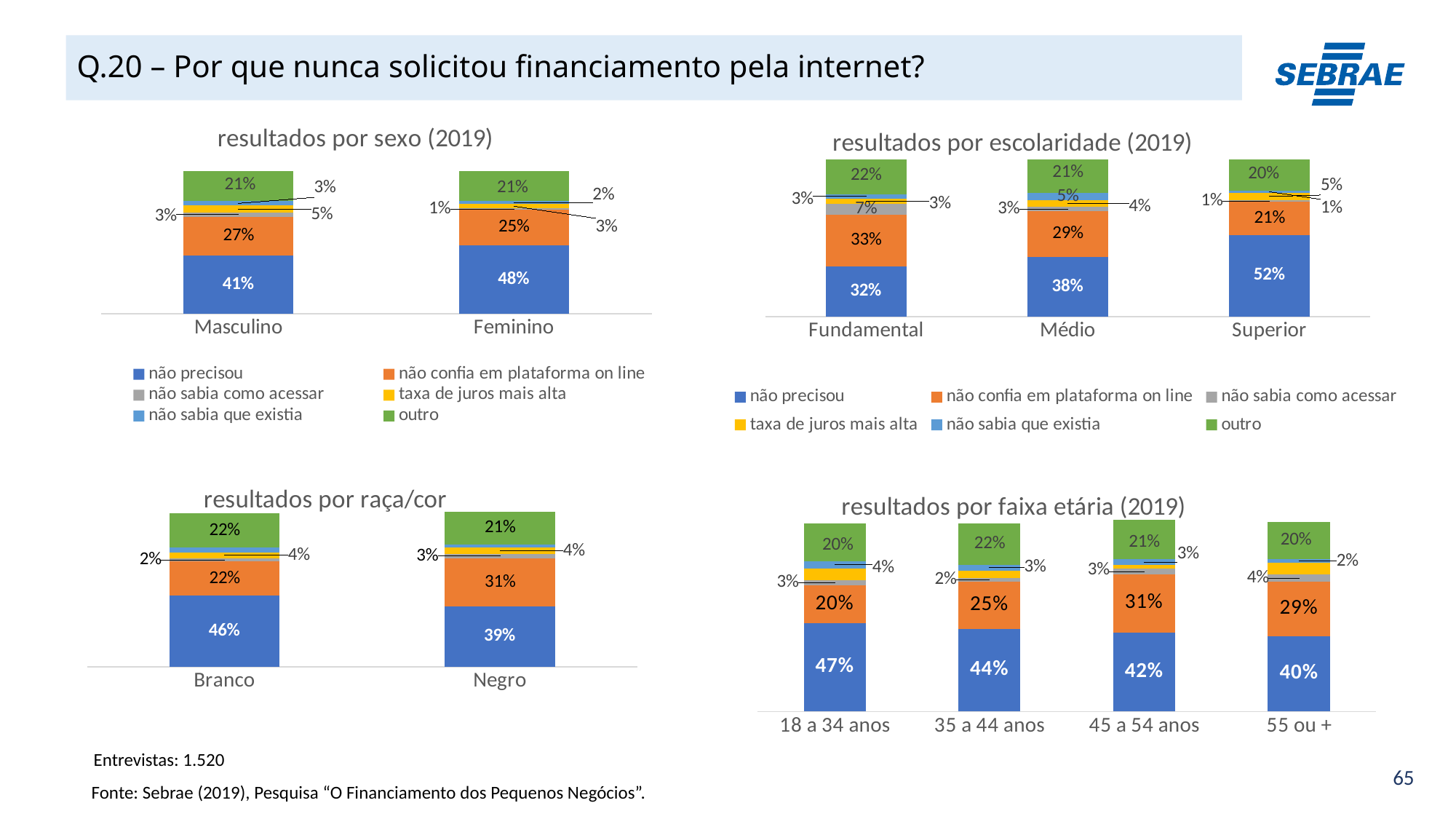
In the 'resultados por raça/cor' chart, what is the value of 'não precisou' for Branco? 46% In the 'resultados por escolaridade (2019)' chart, what is the value of 'não sabia como acessar' for Fundamental? 7% In the 'resultados por faixa etária (2019)' chart, which age group has the lowest value for 'não precisou'? 55 ou + In the 'resultados por raça/cor' chart, which group has the larger value for 'não confia em plataforma on line', Branco or Negro? Negro In the 'resultados por sexo (2019)' chart, what is the value of 'não confia em plataforma on line' for Masculino? 27% How many series does the legend of the 'resultados por sexo (2019)' chart list? 6 What type of chart is the 'resultados por escolaridade (2019)' chart? Stacked bar chart In the 'resultados por escolaridade (2019)' chart, what is the difference between the 'não precisou' values for Superior and Fundamental? 20% How many age groups are shown in the 'resultados por faixa etária (2019)' chart? 4 In the 'resultados por faixa etária (2019)' chart, what is the value of 'não confia em plataforma on line' for 45 a 54 anos? 31% In the 'resultados por sexo (2019)' chart, what is the value of 'não precisou' for Feminino? 48% In the 'resultados por escolaridade (2019)' chart, which education level has the highest value for 'não precisou'? Superior